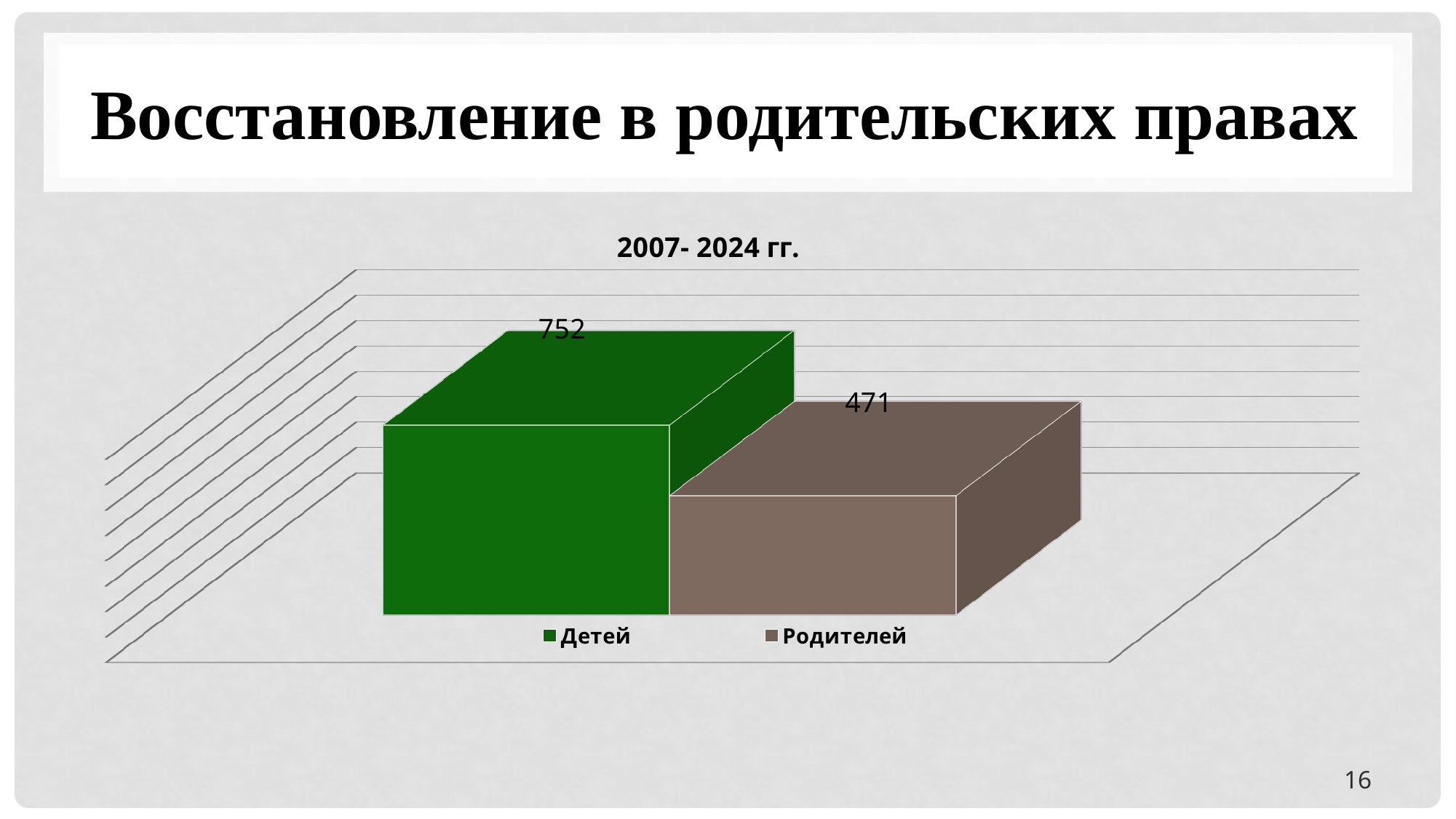
What colour is the bar for Детей? green What kind of chart is shown on the slide? bar chart What is the value for Родителей? 471 Which series has the lowest value? Родителей What is the difference between the values for Детей and Родителей? 281 Which is larger, the value for Детей or the value for Родителей? Детей What is the value for Детей? 752 Which series has the highest value? Детей How many series does the legend list? 2 How many bars are plotted on the chart? 2 What is the title of the chart? 2007- 2024 гг.